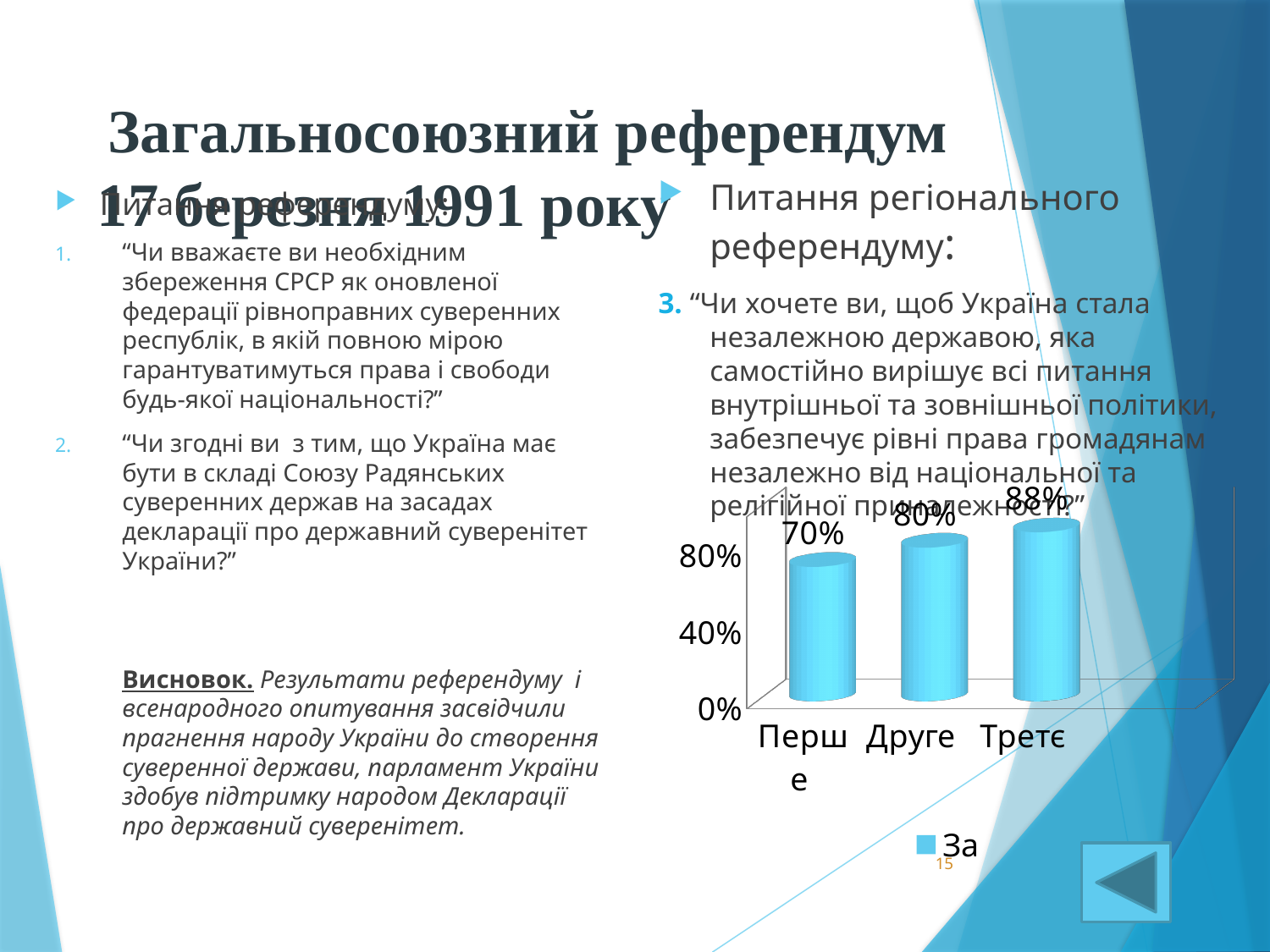
What is the value for Перше? 70% Which is larger, the value for Друге or the value for Перше? Друге What is the name of the series listed in the chart legend? За Is the value for Перше greater or less than 40%? greater Which category has the lowest value? Перше What is the difference between the values for Третє and Перше? 18% What is the value for Друге? 80% What is the value for Третє? 88% What is the difference between the values for Друге and Перше? 10% What kind of chart is shown on the slide? bar chart How many categories are shown on the chart? 3 Which category has the highest value? Третє